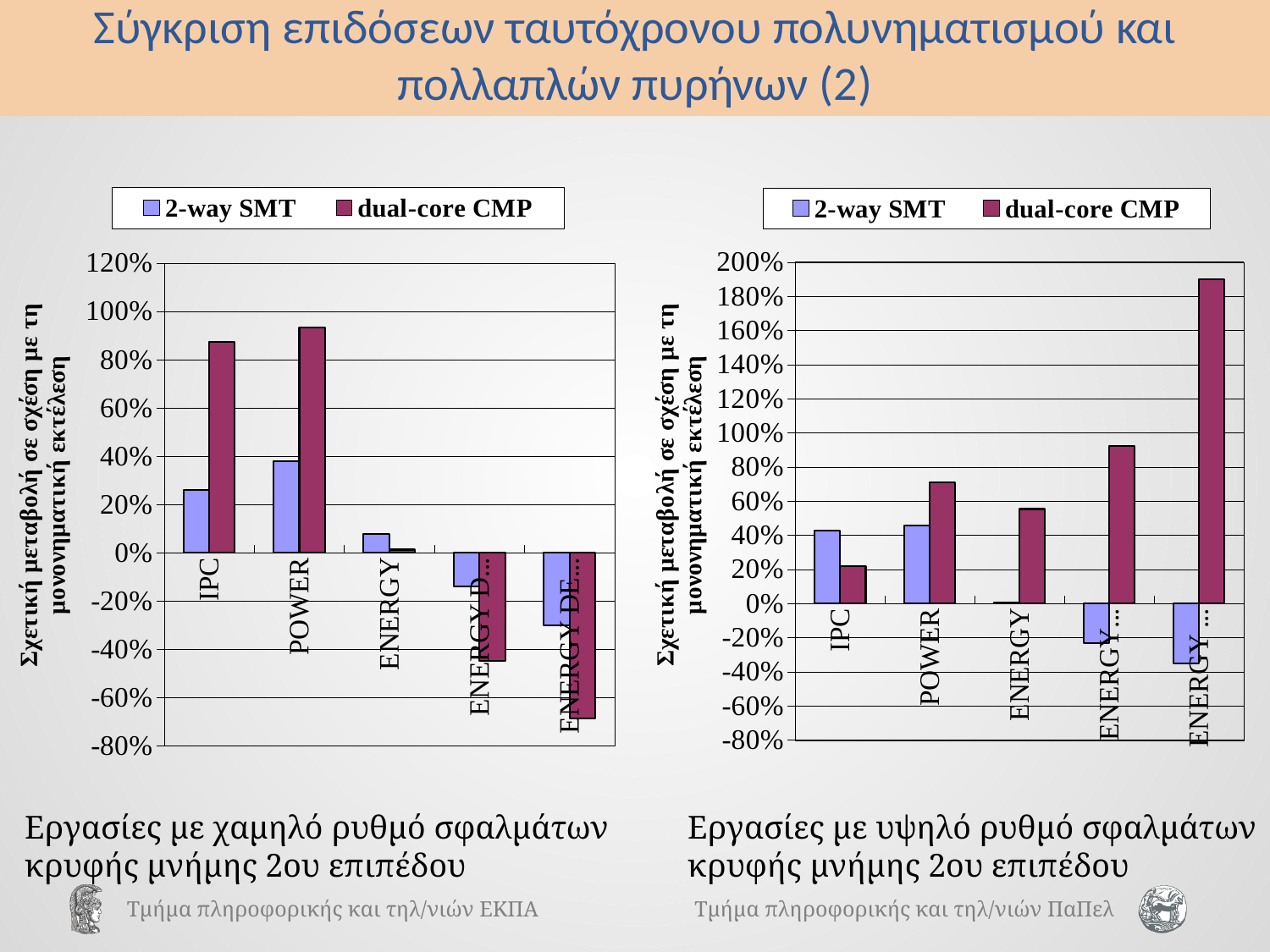
In the left chart, which category has the highest dual-core CMP value? POWER In the right chart, is the dual-core CMP value for ENERGY greater or less than 40%? greater How many categories are plotted on the x axis of the right chart? 5 How many series does the legend of the left chart list? 2 In the left chart, is the dual-core CMP value for ENERGY greater or less than 20%? less What kind of chart is the left chart on the slide? bar chart What are the two series named in the legend of the right chart? 2-way SMT and dual-core CMP In the right chart, for IPC, which series has the larger value: 2-way SMT or dual-core CMP? 2-way SMT In the left chart, is the 2-way SMT value for POWER greater or less than 20%? greater In the left chart, for IPC, which series has the larger value: 2-way SMT or dual-core CMP? dual-core CMP